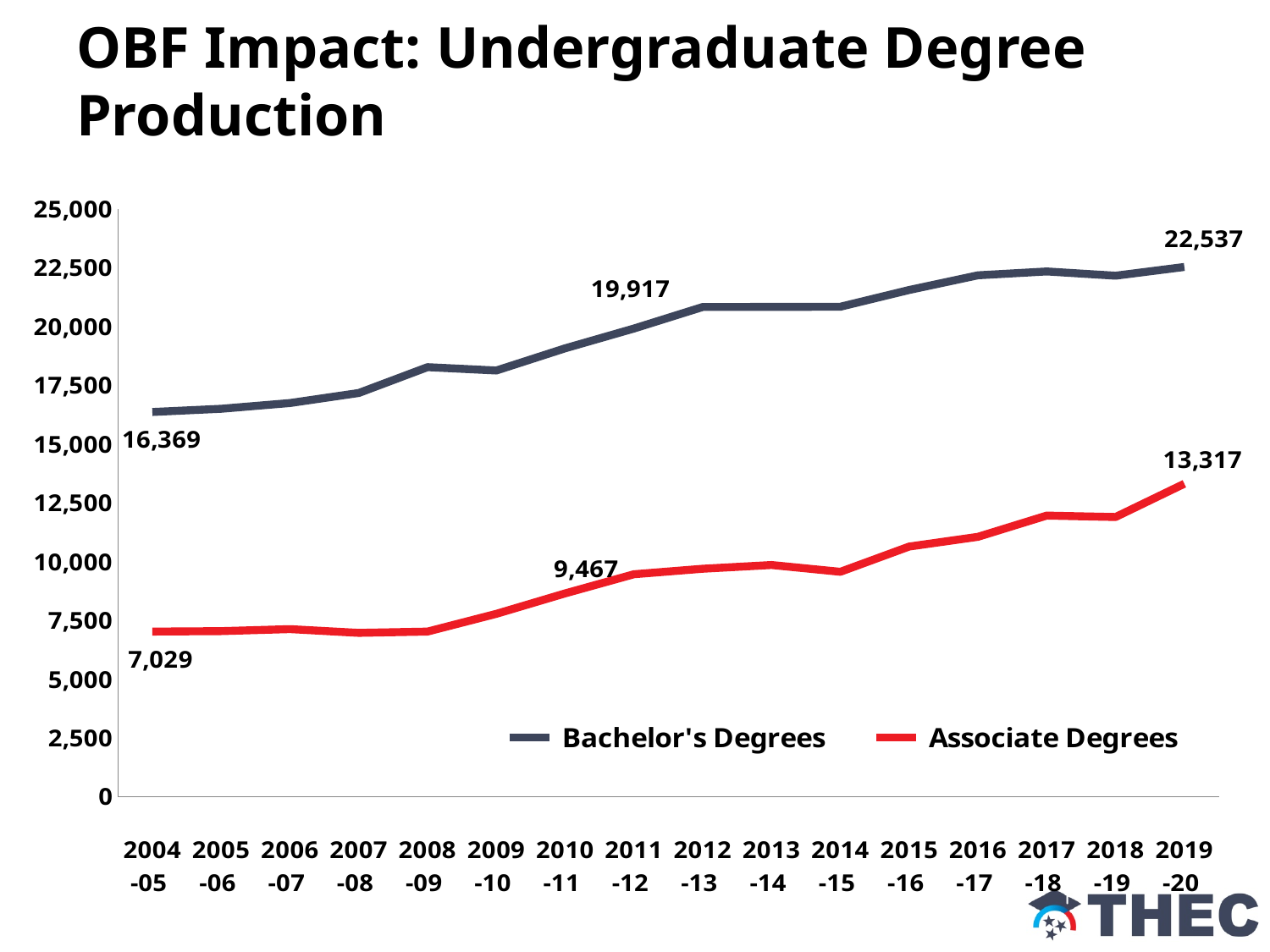
What is the value for Bachelor's Degrees in 2019-20? 22,537 What type of chart is shown on the slide? line chart What is the value for Associate Degrees in 2004-05? 7,029 What is the difference between Bachelor's Degrees and Associate Degrees in 2019-20? 9,220 Do Associate Degrees generally rise or fall from 2004-05 to 2019-20? rise How many series does the legend list? 2 What is the value for Bachelor's Degrees in 2004-05? 16,369 Which series has the higher value in 2011-12, Bachelor's Degrees or Associate Degrees? Bachelor's Degrees Is the value for Associate Degrees in 2014-15 greater or less than 10,000? less What is the difference between Bachelor's Degrees in 2019-20 and in 2004-05? 6,168 How many academic years are shown on the x axis? 16 What is the value for Associate Degrees in 2019-20? 13,317